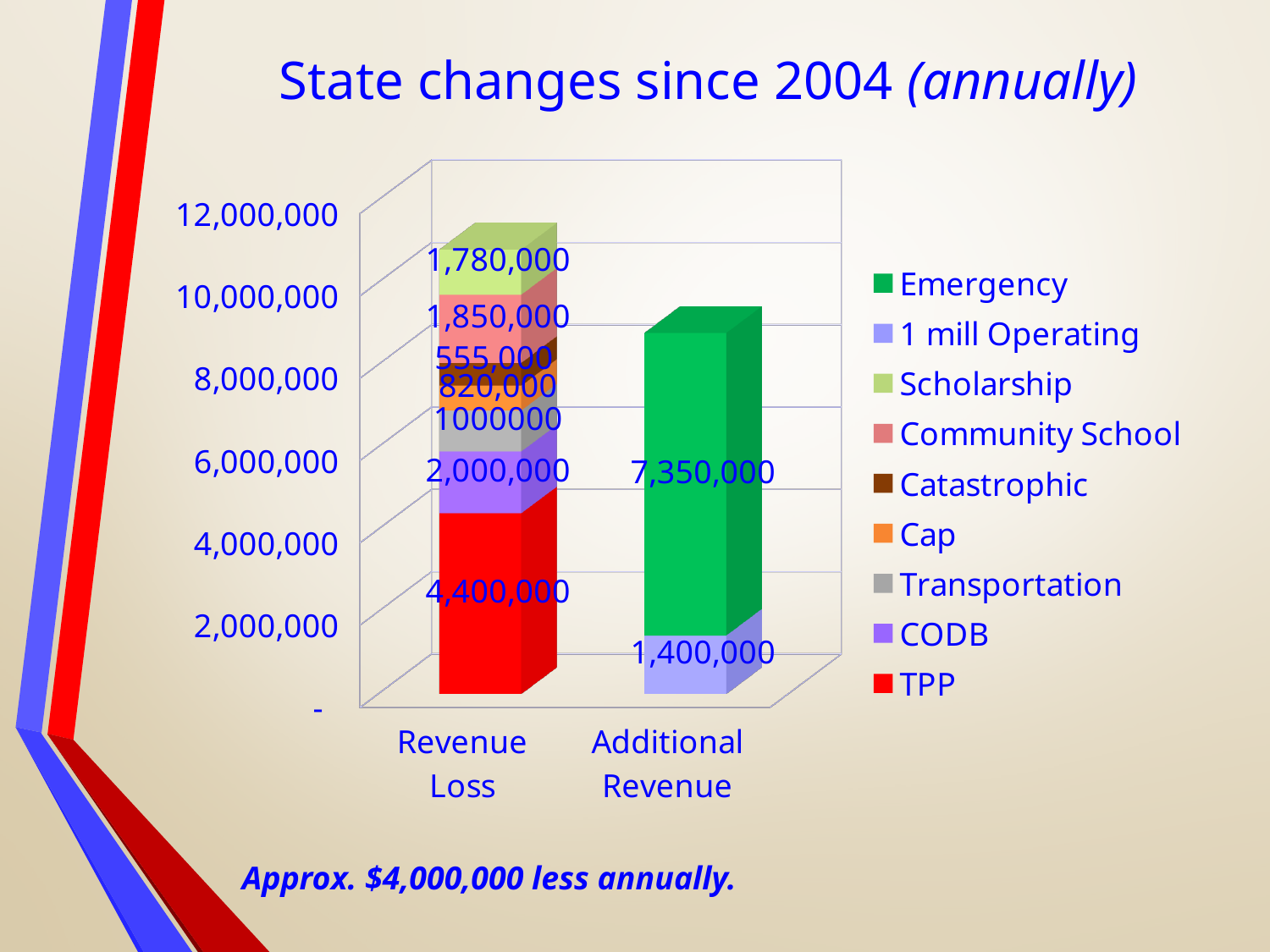
What is the value of the Scholarship segment in the Revenue Loss bar? 1,780,000 How many series does the legend list? 9 Which is larger in the Revenue Loss bar, the CODB segment or the Cap segment? CODB What is the difference between the Community School and Catastrophic segments in the Revenue Loss bar? 1,295,000 Which segment of the Revenue Loss bar has the largest value? TPP What is the value of the Cap segment in the Revenue Loss bar? 820,000 What type of chart is shown on the slide? Stacked bar chart What is the total of the Additional Revenue bar? 8,750,000 What is the value of the TPP segment in the Revenue Loss bar? 4,400,000 What is the value of the Emergency segment in the Additional Revenue bar? 7,350,000 Which segment of the Revenue Loss bar has the smallest value? Catastrophic What is the value of the 1 mill Operating segment in the Additional Revenue bar? 1,400,000